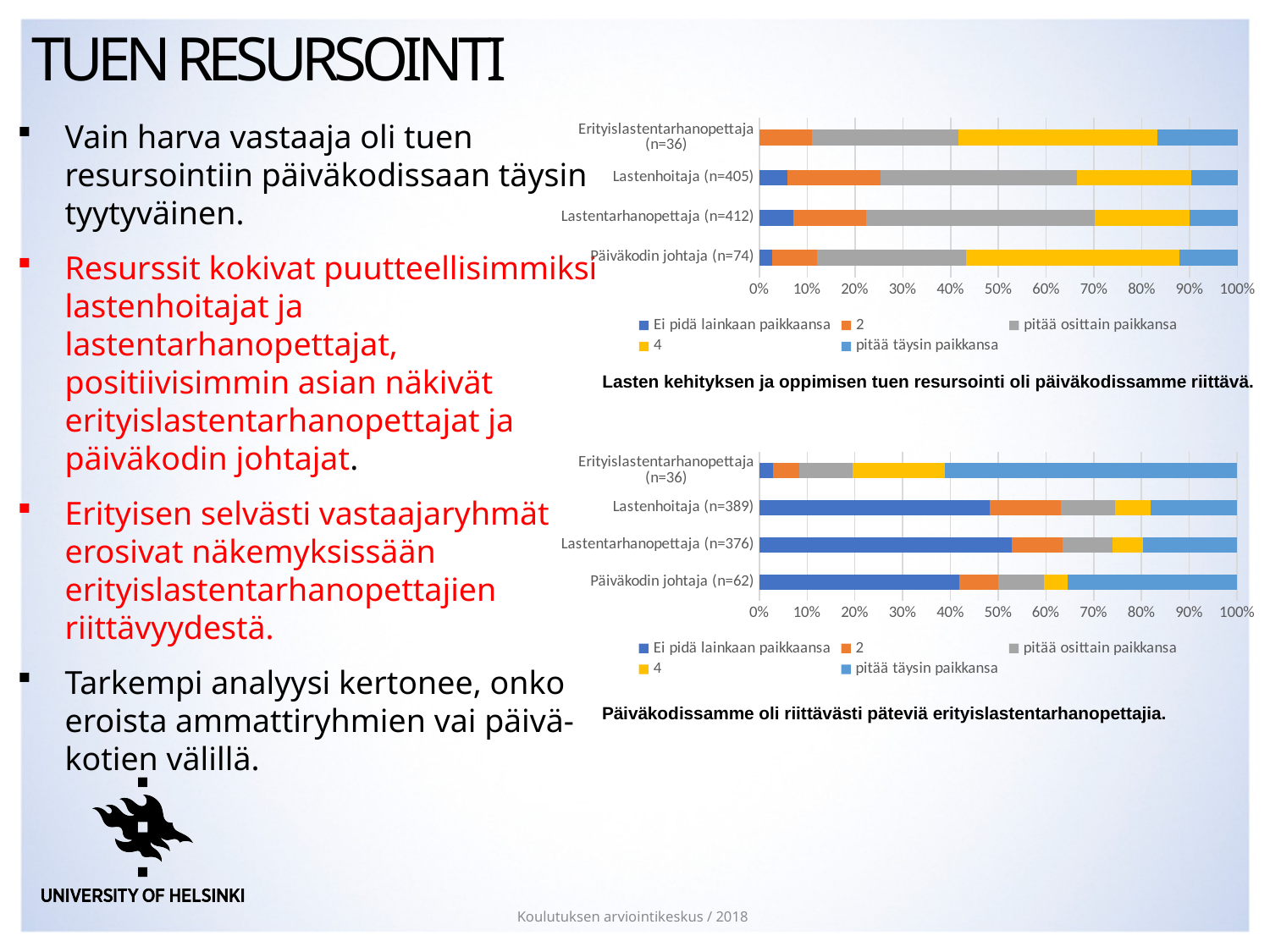
What kind of chart is the top chart on the slide? stacked bar chart In the top chart, what is the n given for Lastenhoitaja? n=405 In the bottom chart, is the 'pitää täysin paikkansa' share for Erityislastentarhanopettaja (n=36) greater or less than 50%? greater In the bottom chart, is the 'Ei pidä lainkaan paikkaansa' share for Lastenhoitaja (n=389) greater or less than 40%? greater In the bottom chart, which group has the smallest 'Ei pidä lainkaan paikkaansa' share? Erityislastentarhanopettaja (n=36) In the top chart, is the 'Ei pidä lainkaan paikkaansa' share for Lastentarhanopettaja (n=412) greater or less than 20%? less How many series does the legend of the bottom chart list? 5 In the bottom chart, which group has the largest 'pitää täysin paikkansa' share? Erityislastentarhanopettaja (n=36) How many respondent groups (categories) are shown in the top chart? 4 In the bottom chart, which has the larger 'Ei pidä lainkaan paikkaansa' share: Lastentarhanopettaja (n=376) or Erityislastentarhanopettaja (n=36)? Lastentarhanopettaja (n=376) What is the title printed under the top chart? Lasten kehityksen ja oppimisen tuen resursointi oli päiväkodissamme riittävä.